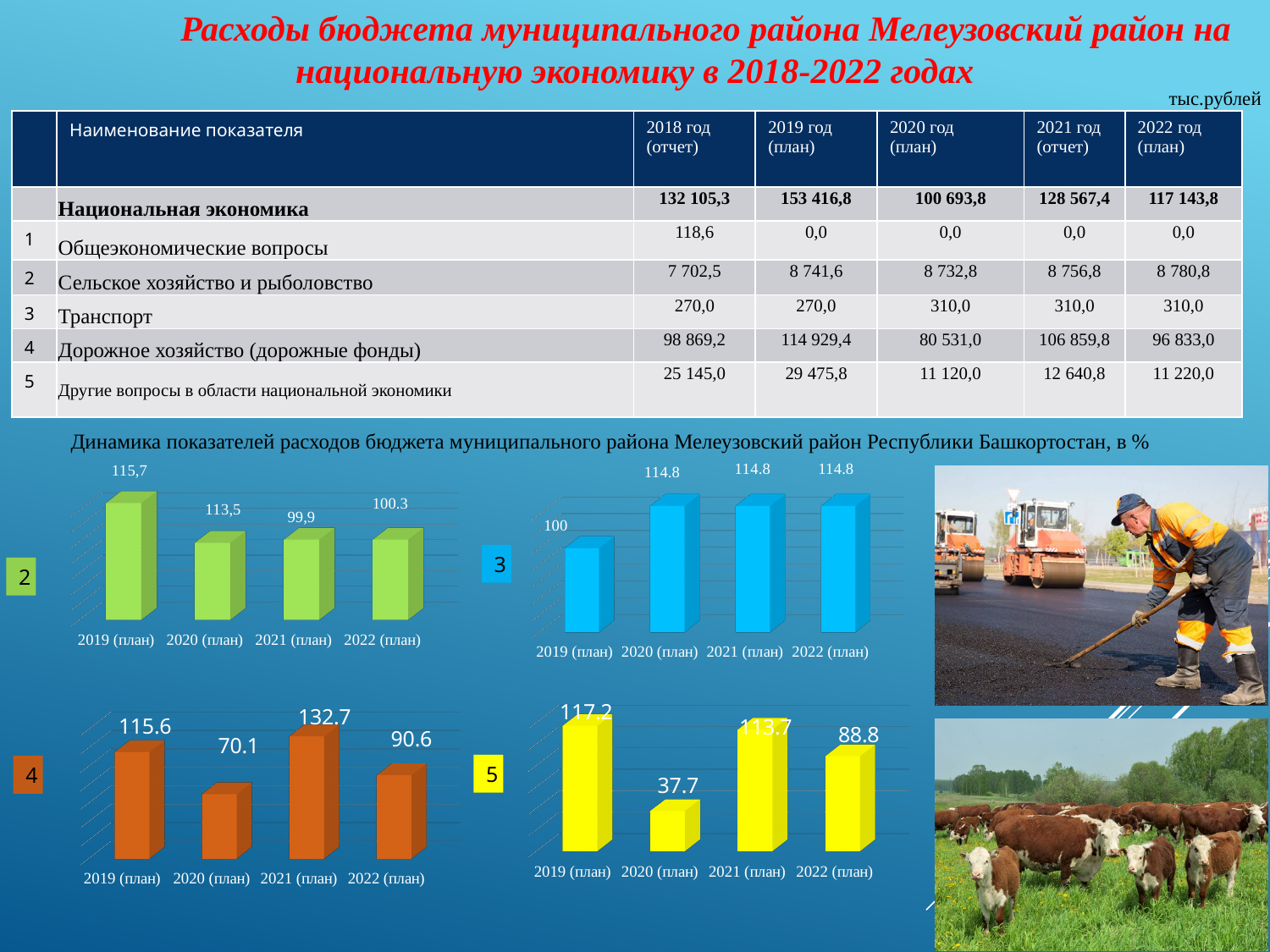
In the yellow bar chart labelled 5 (bottom middle), which is larger, the value for 2019 (план) or 2022 (план)? 2019 (план) In the yellow bar chart labelled 5 (bottom middle), which category has the lowest value? 2020 (план) In the blue bar chart labelled 3 (top middle), what is the value for 2019 (план)? 100 What type of chart is the chart labelled 4 (bottom left)? Bar chart In the blue bar chart labelled 3 (top middle), what is the value for 2021 (план)? 114.8 In the yellow bar chart labelled 5 (bottom middle), what is the value for 2020 (план)? 37.7 In the orange bar chart labelled 4 (bottom left), what is the difference between the values for 2021 (план) and 2020 (план)? 62.6 In the green bar chart labelled 2 (top left), which category has the lowest value? 2021 (план) In the orange bar chart labelled 4 (bottom left), what is the value for 2020 (план)? 70.1 In the green bar chart labelled 2 (top left), what is the value for 2019 (план)? 115,7 In the orange bar chart labelled 4 (bottom left), which category has the highest value? 2021 (план) How many categories are shown in the green bar chart labelled 2 (top left)? 4